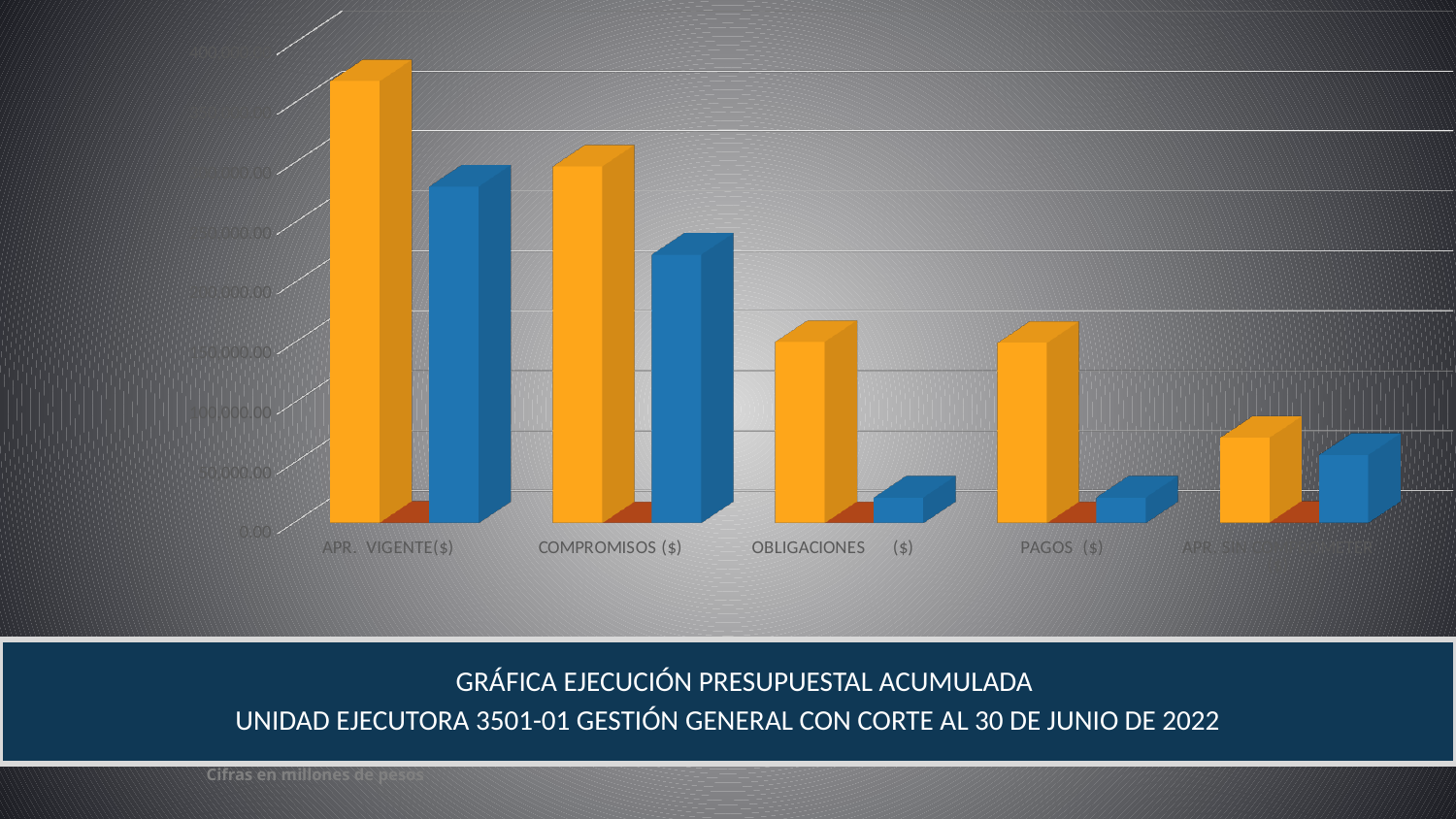
Is the orange bar for APR. VIGENTE($) taller or shorter than the orange bar for COMPROMISOS ($)? taller What unit note is printed below the chart title? Cifras en millones de pesos Which category has the tallest orange bar? APR. VIGENTE($) For OBLIGACIONES ($), which bar is taller, the orange one or the blue one? the orange one How many categories are shown along the x axis of the chart? 5 Which has the taller blue bar, COMPROMISOS ($) or OBLIGACIONES ($)? COMPROMISOS ($) Which category has the tallest blue bar? APR. VIGENTE($) Do the orange bars generally rise or fall from left to right across the categories? fall What is the first line of the chart's title shown in the blue band? GRÁFICA EJECUCIÓN PRESUPUESTAL ACUMULADA What kind of chart is shown on the slide? bar chart How many bars are plotted for each category in the chart? 3